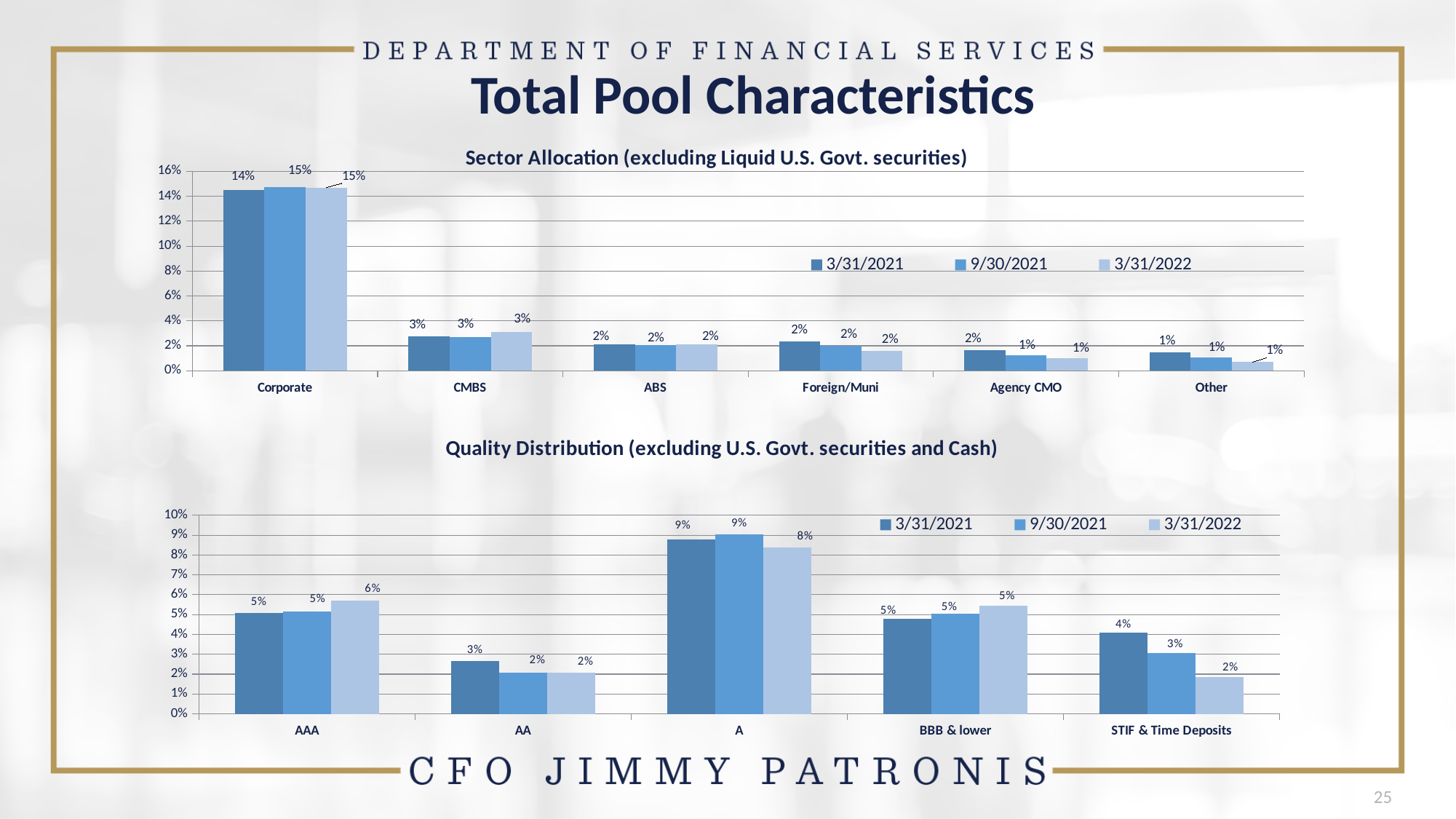
In the Quality Distribution chart, what is the value for AAA on 3/31/2022? 6% In the Sector Allocation chart, what is the value for Corporate on 3/31/2021? 14% In the Quality Distribution chart, which is larger: AAA on 3/31/2022 or BBB & lower on 3/31/2022? AAA on 3/31/2022 In the Quality Distribution chart, do the values for STIF & Time Deposits rise or fall from 3/31/2021 to 3/31/2022? fall In the Sector Allocation chart, what is the value for Agency CMO on 3/31/2021? 2% In the Quality Distribution chart, what is the difference between the value for A on 3/31/2021 and the value for AA on 3/31/2021? 6 percentage points In the Quality Distribution chart, what is the value for STIF & Time Deposits on 3/31/2022? 2% In the Quality Distribution chart, which category has the highest value on 9/30/2021? A In the Sector Allocation chart, which category has the highest values across all three dates? Corporate In the Sector Allocation chart, how many categories are shown on the x axis? 6 In the Sector Allocation chart, how many series does the legend list? 3 What kind of chart is the Quality Distribution chart? bar chart